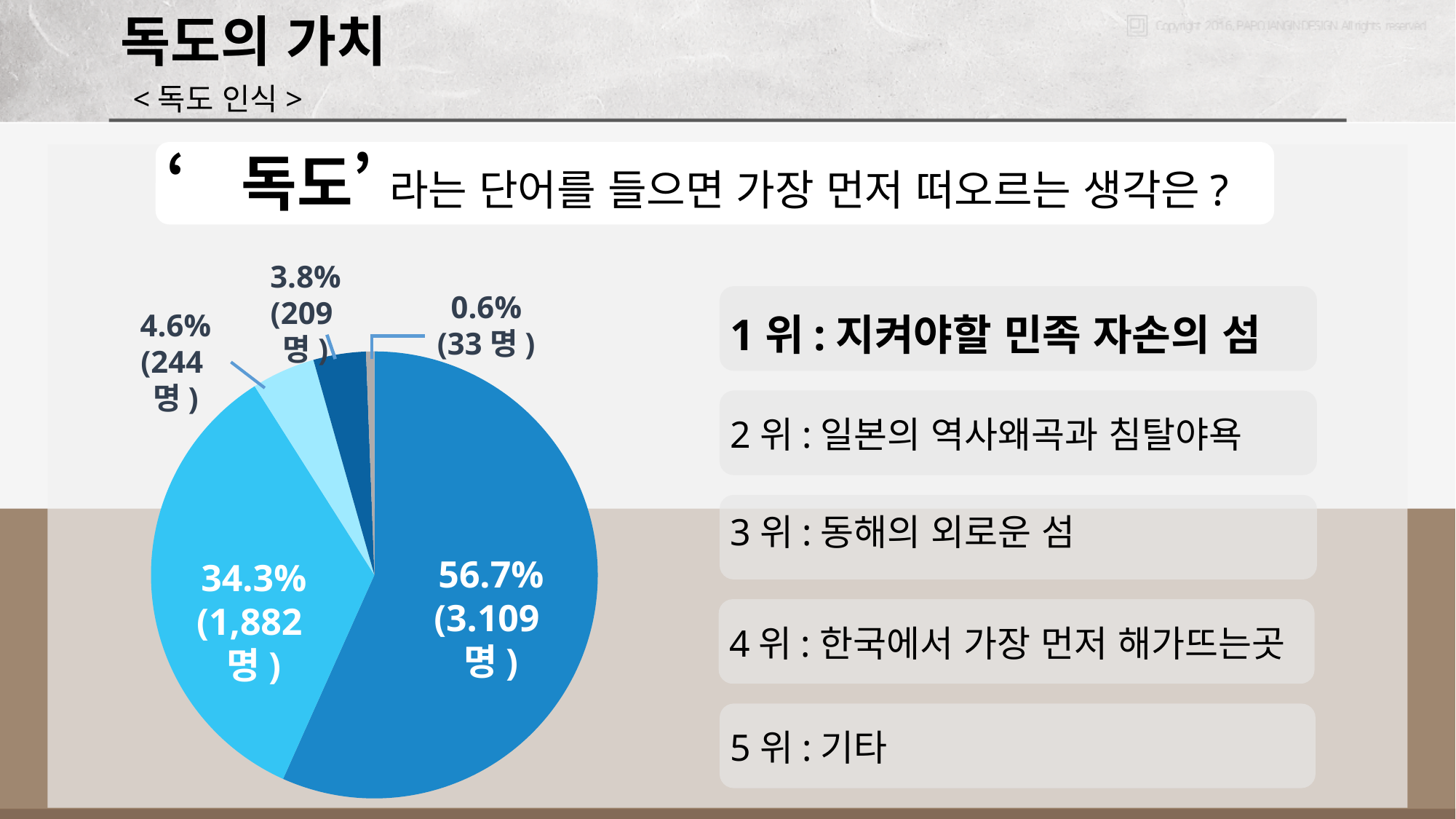
Which slice is larger: the one with 244 명 or the one with 209 명? 244 명 What percentage does the smallest slice of the pie chart represent? 0.6% How many slices does the pie chart have? 5 How many respondents does the 4.6% slice represent? 244 명 How many respondents does the 56.7% slice represent? 3.109 명 How many respondents does the 3.8% slice represent? 209 명 What percentage does the largest slice of the pie chart represent? 56.7% How many respondents does the 0.6% slice represent? 33 명 According to the ranking list next to the pie chart, what is the 1위 (first-ranked) response? 지켜야할 민족 자손의 섬 How many respondents does the 34.3% slice represent? 1,882 명 What kind of chart is shown on the slide? pie chart What is the difference in percentage points between the largest slice (56.7%) and the second-largest slice (34.3%)? 22.4